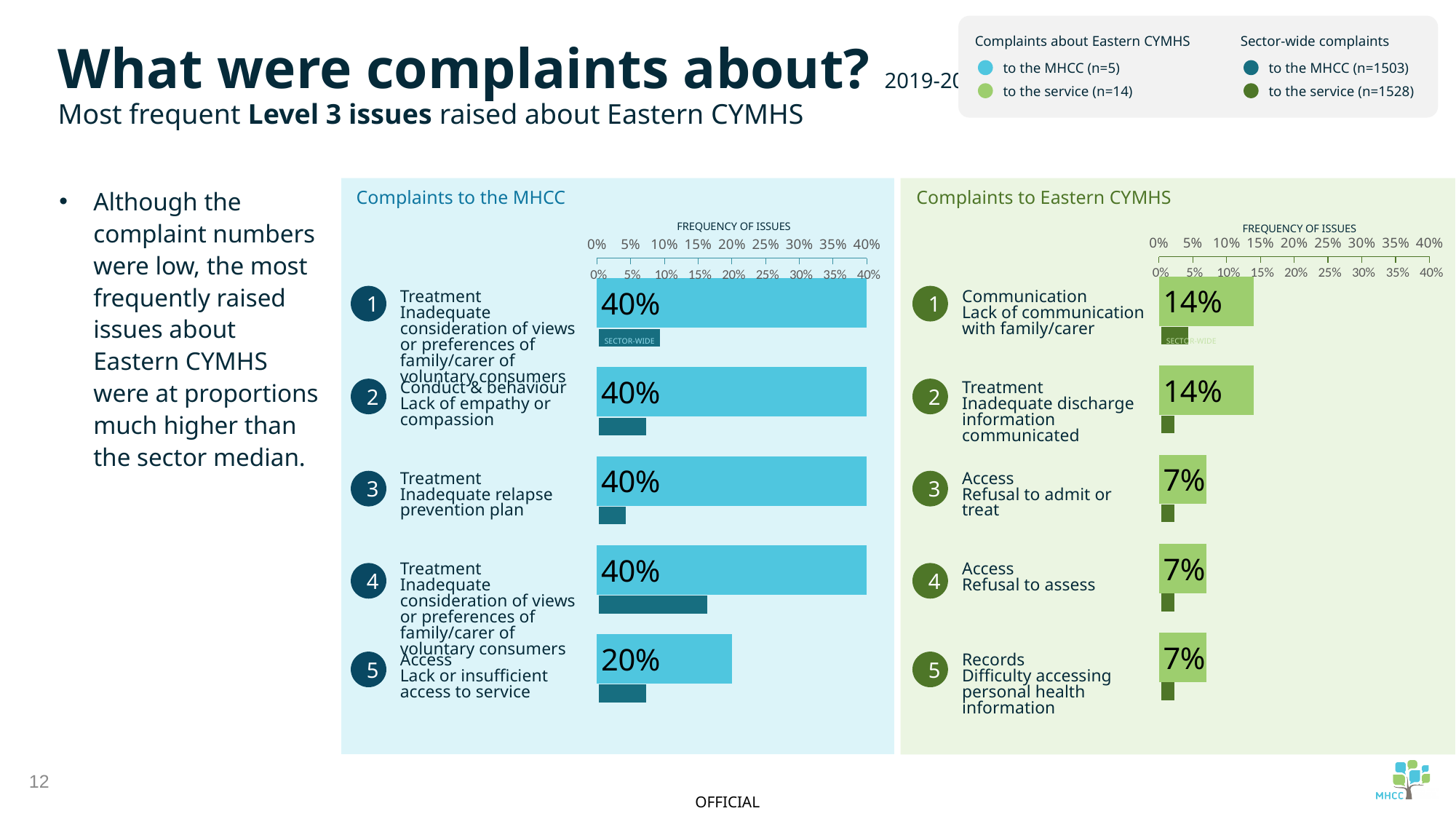
In the 'Complaints to Eastern CYMHS' chart, what is the value for 'Access – Refusal to assess'? 7% What kind of chart is the 'Complaints to Eastern CYMHS' chart? Bar chart In the 'Complaints to Eastern CYMHS' chart, is the sector-wide value for 'Communication – Lack of communication with family/carer' greater or less than 10%? less In the 'Complaints to the MHCC' chart, what is the value for 'Access – Lack or insufficient access to service'? 20% In the 'Complaints to the MHCC' chart, is the sector-wide value for issue 4 ('Treatment – Inadequate consideration of views or preferences of family/carer of voluntary consumers') greater or less than 10%? greater What is the axis title shown above the percentage scale in both charts? FREQUENCY OF ISSUES In the 'Complaints to the MHCC' chart, which issue has the lowest Eastern CYMHS value? Access – Lack or insufficient access to service In the 'Complaints to Eastern CYMHS' chart, what is the difference between the value for 'Communication – Lack of communication with family/carer' and the value for 'Records – Difficulty accessing personal health information'? 7% In the 'Complaints to Eastern CYMHS' chart, which is larger: 'Treatment – Inadequate discharge information communicated' or 'Access – Refusal to admit or treat'? Treatment – Inadequate discharge information communicated In the 'Complaints to Eastern CYMHS' chart, what is the value for 'Communication – Lack of communication with family/carer'? 14% How many issues are listed in the 'Complaints to the MHCC' chart? 5 In the 'Complaints to the MHCC' chart, what is the difference between the value for 'Treatment – Inadequate relapse prevention plan' and the value for 'Access – Lack or insufficient access to service'? 20%